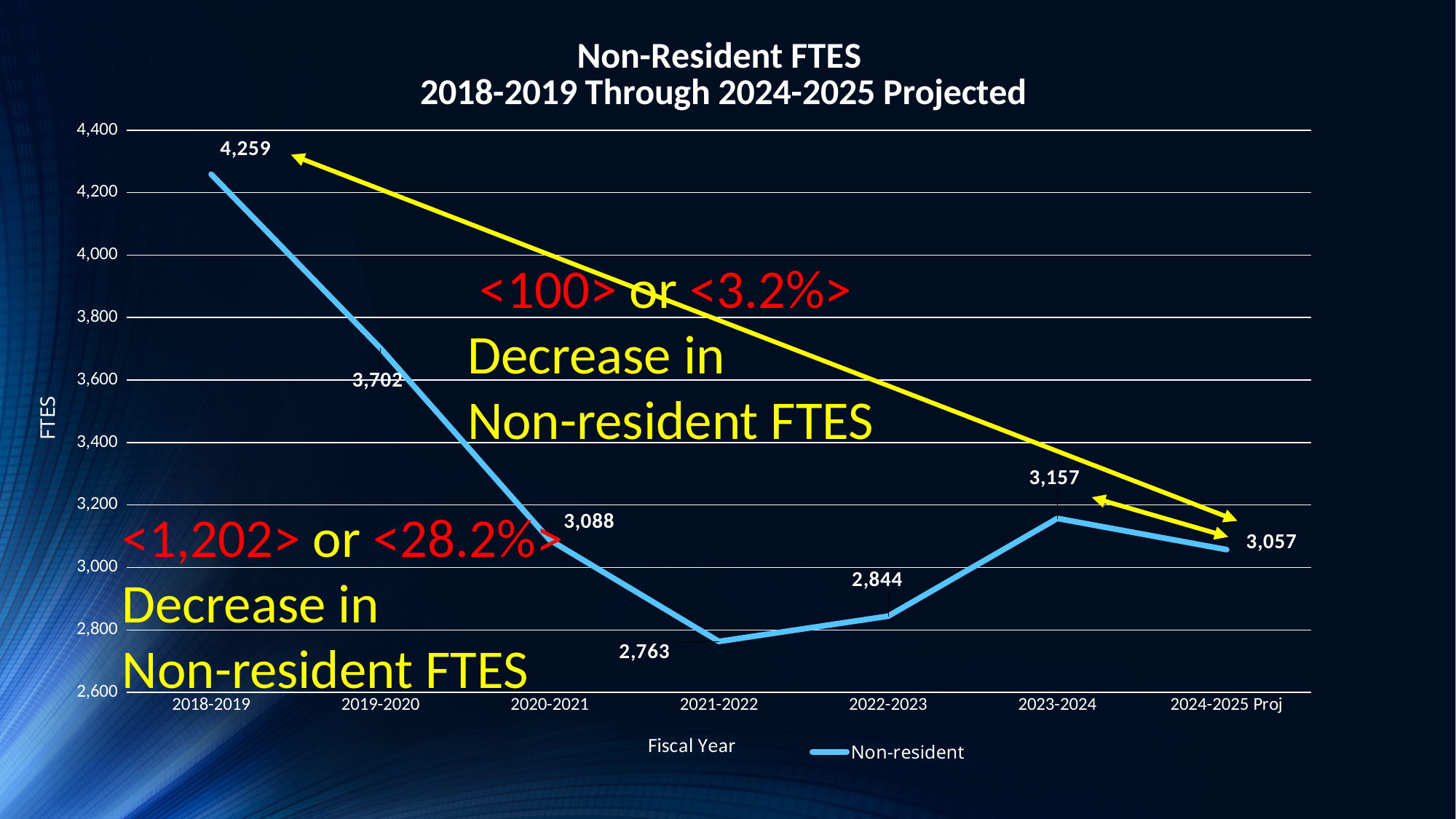
Is the Non-resident FTES value for 2022-2023 greater or less than 3,000? less What is the Non-resident FTES value for 2023-2024? 3,157 What is the Non-resident FTES value for 2021-2022? 2,763 What is the difference between the Non-resident FTES for 2018-2019 and 2019-2020? 557 Which fiscal year has the highest Non-resident FTES? 2018-2019 What is the Non-resident FTES value for 2018-2019? 4,259 What is the projected Non-resident FTES value for 2024-2025? 3,057 Which fiscal year has the lowest Non-resident FTES? 2021-2022 Does the Non-resident FTES rise or fall from 2018-2019 to 2021-2022? fall What kind of chart is shown on the slide? line chart How many fiscal years are plotted on the chart? 7 Which is larger, the Non-resident FTES for 2020-2021 or for 2022-2023? 2020-2021